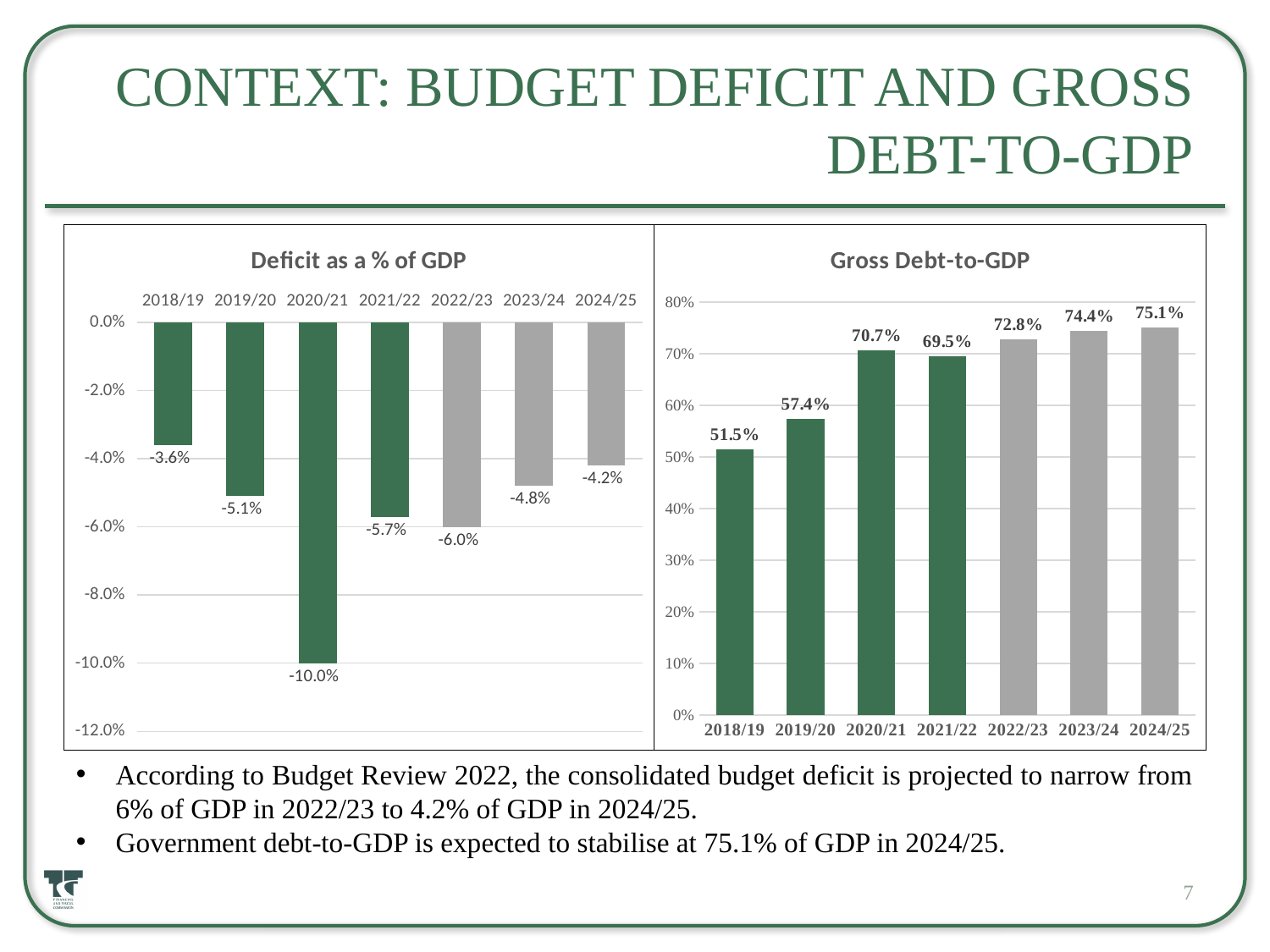
How many years are shown in the 'Deficit as a % of GDP' chart? 7 In the 'Gross Debt-to-GDP' chart, what is the value for 2018/19? 51.5% In the 'Gross Debt-to-GDP' chart, which year has the highest value? 2024/25 In the 'Gross Debt-to-GDP' chart, what is the difference between the values for 2024/25 and 2018/19? 23.6% In the 'Gross Debt-to-GDP' chart, which is larger, the value for 2020/21 or the value for 2021/22? 2020/21 What kind of chart is the 'Gross Debt-to-GDP' chart? bar chart What is the title of the chart on the left side of the slide? Deficit as a % of GDP In the 'Deficit as a % of GDP' chart, which year has the smallest deficit (value closest to zero)? 2018/19 In the 'Gross Debt-to-GDP' chart, do the values generally rise or fall from 2018/19 to 2024/25? rise In the 'Gross Debt-to-GDP' chart, is the value for 2019/20 greater or less than 60%? less In the 'Deficit as a % of GDP' chart, what is the value for 2022/23? -6.0% In the 'Deficit as a % of GDP' chart, what is the value for 2020/21? -10.0%